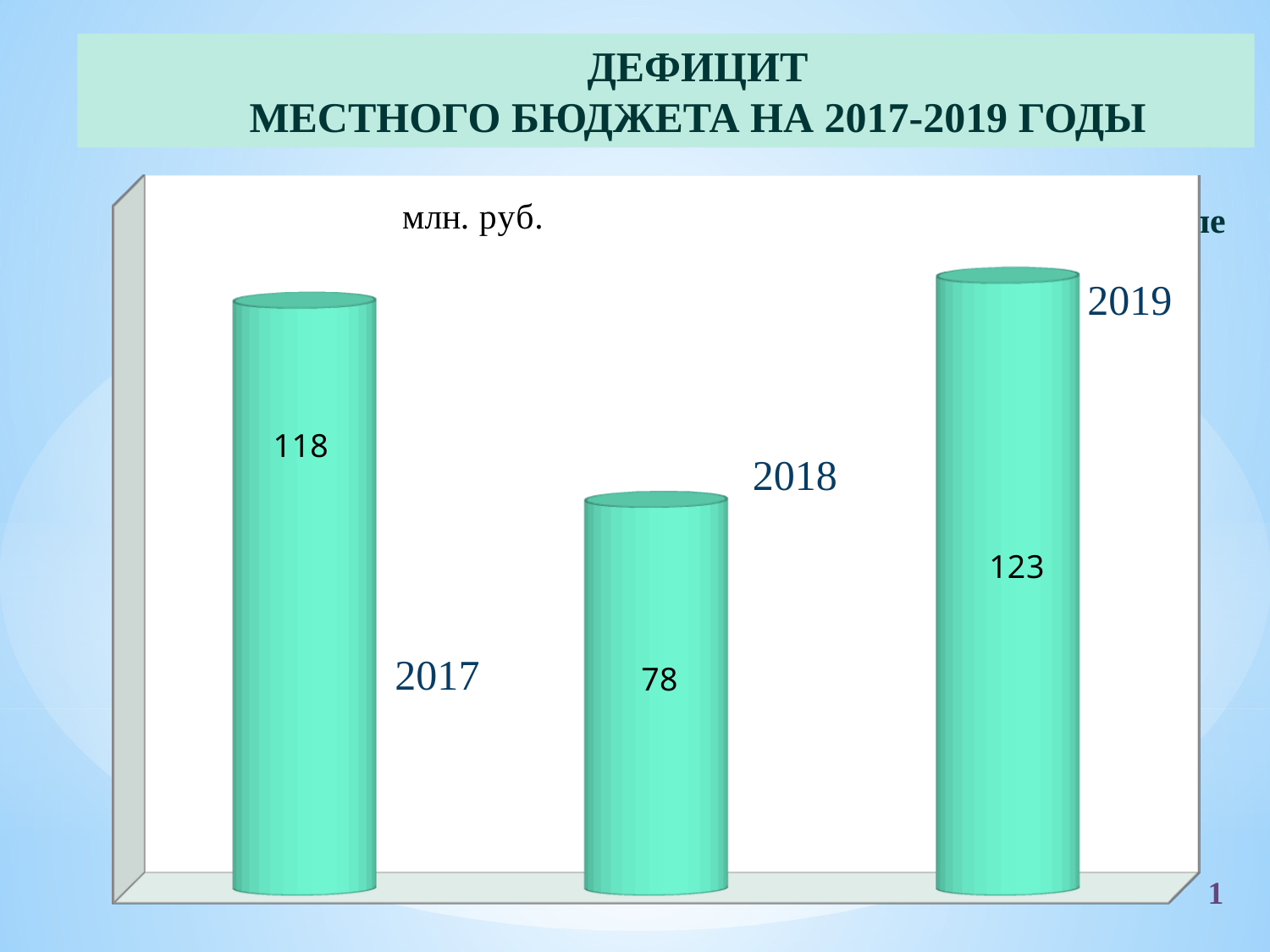
What kind of chart is shown on the slide? bar chart What is the difference between the deficit in 2017 and the deficit in 2018? 40 In what units are the values on the chart given? млн. руб. What is the title of the slide? ДЕФИЦИТ МЕСТНОГО БЮДЖЕТА НА 2017-2019 ГОДЫ What is the difference between the deficit in 2019 and the deficit in 2018? 45 What is the local budget deficit for 2018? 78 How many years are shown in the chart? 3 Which year has the highest deficit? 2019 Which is larger, the deficit in 2017 or in 2019? 2019 Which year has the lowest deficit? 2018 What is the local budget deficit for 2019? 123 What is the local budget deficit for 2017? 118